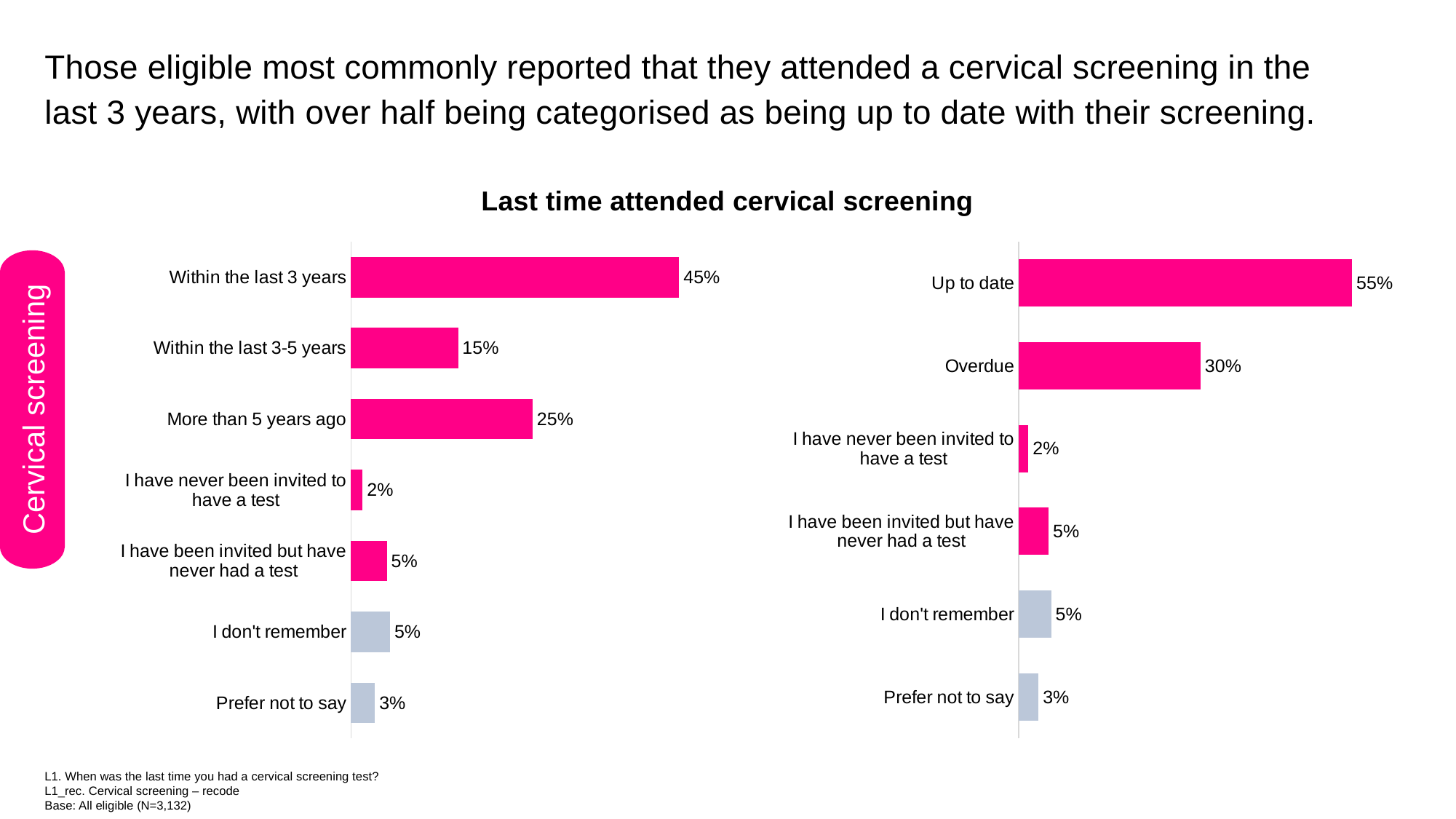
In the right chart, which category has the highest value? Up to date What type of chart is used on this slide? Bar chart In the left chart, what is the difference between 'Within the last 3 years' and 'Within the last 3-5 years'? 30 percentage points In the right chart, what percentage are categorised as Overdue? 30% In the left chart, what is the value for 'More than 5 years ago'? 25% How many categories are shown in the right chart? 6 How many categories are shown in the left chart? 7 In the left chart, which is larger: 'More than 5 years ago' or 'Within the last 3-5 years'? More than 5 years ago In the left chart, what percentage reported attending a cervical screening within the last 3 years? 45% What is the title shown above the charts? Last time attended cervical screening In the left chart, which category has the lowest value? I have never been invited to have a test In the right chart, what is the difference between 'Up to date' and 'Overdue'? 25 percentage points